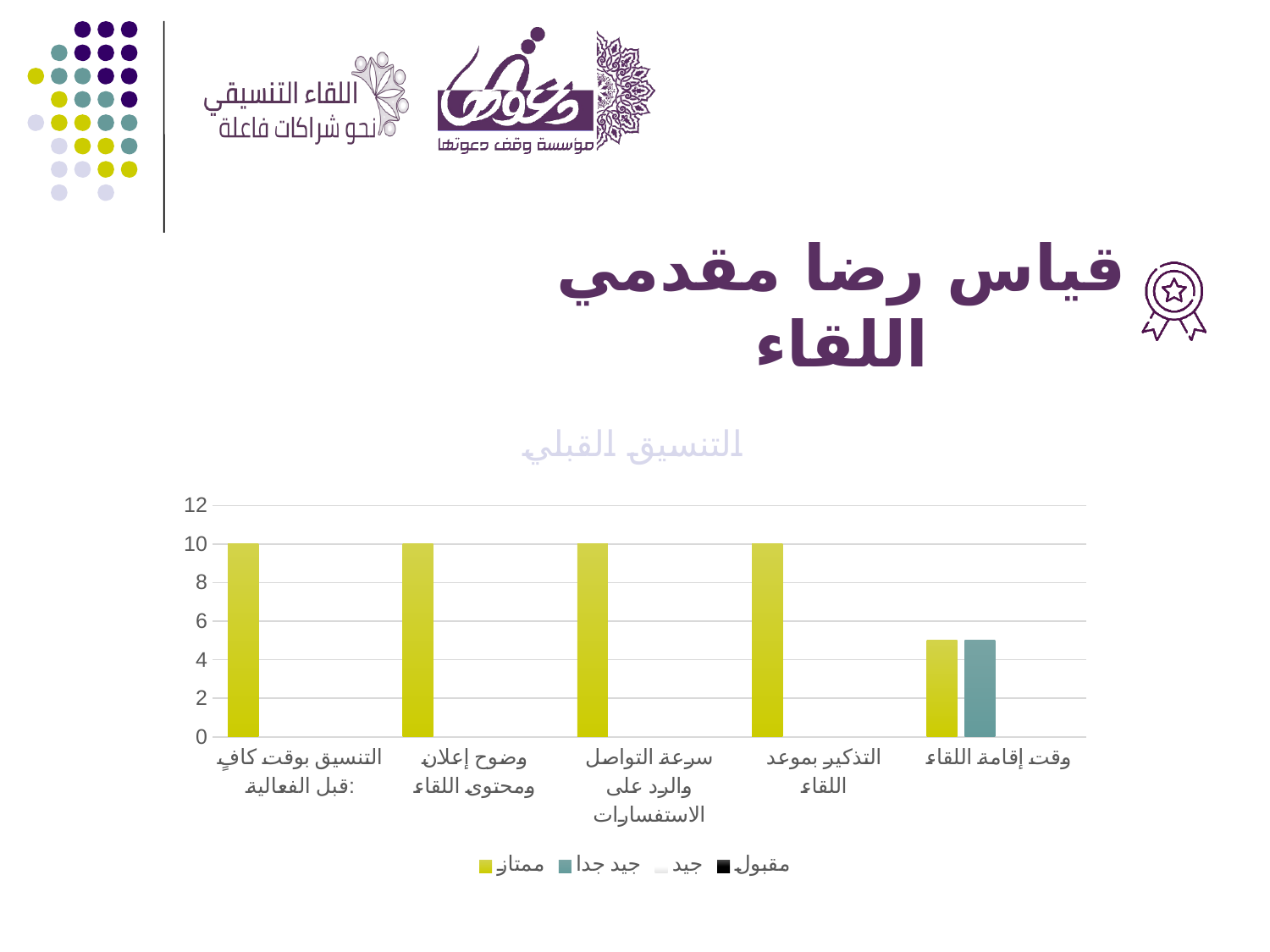
What kind of chart is shown on the slide? bar chart How many series does the chart legend list? 4 What is the value of ممتاز for التذكير بموعد اللقاء? 10 Which category has the lowest value for ممتاز? وقت إقامة اللقاء Is the value of ممتاز for وقت إقامة اللقاء greater or less than 8? less What is the value of ممتاز for وضوح إعلان ومحتوى اللقاء? 10 Which is larger: the ممتاز value for التنسيق بوقت كافٍ قبل الفعالية or the ممتاز value for وقت إقامة اللقاء? التنسيق بوقت كافٍ قبل الفعالية How many categories are shown on the x axis of the chart? 5 What is the value of ممتاز for سرعة التواصل والرد على الاستفسارات? 10 Is the value of جيد جدا for وقت إقامة اللقاء greater or less than 4? greater What is the title of the chart? التنسيق القبلي Which category is the only one with a visible جيد جدا bar? وقت إقامة اللقاء